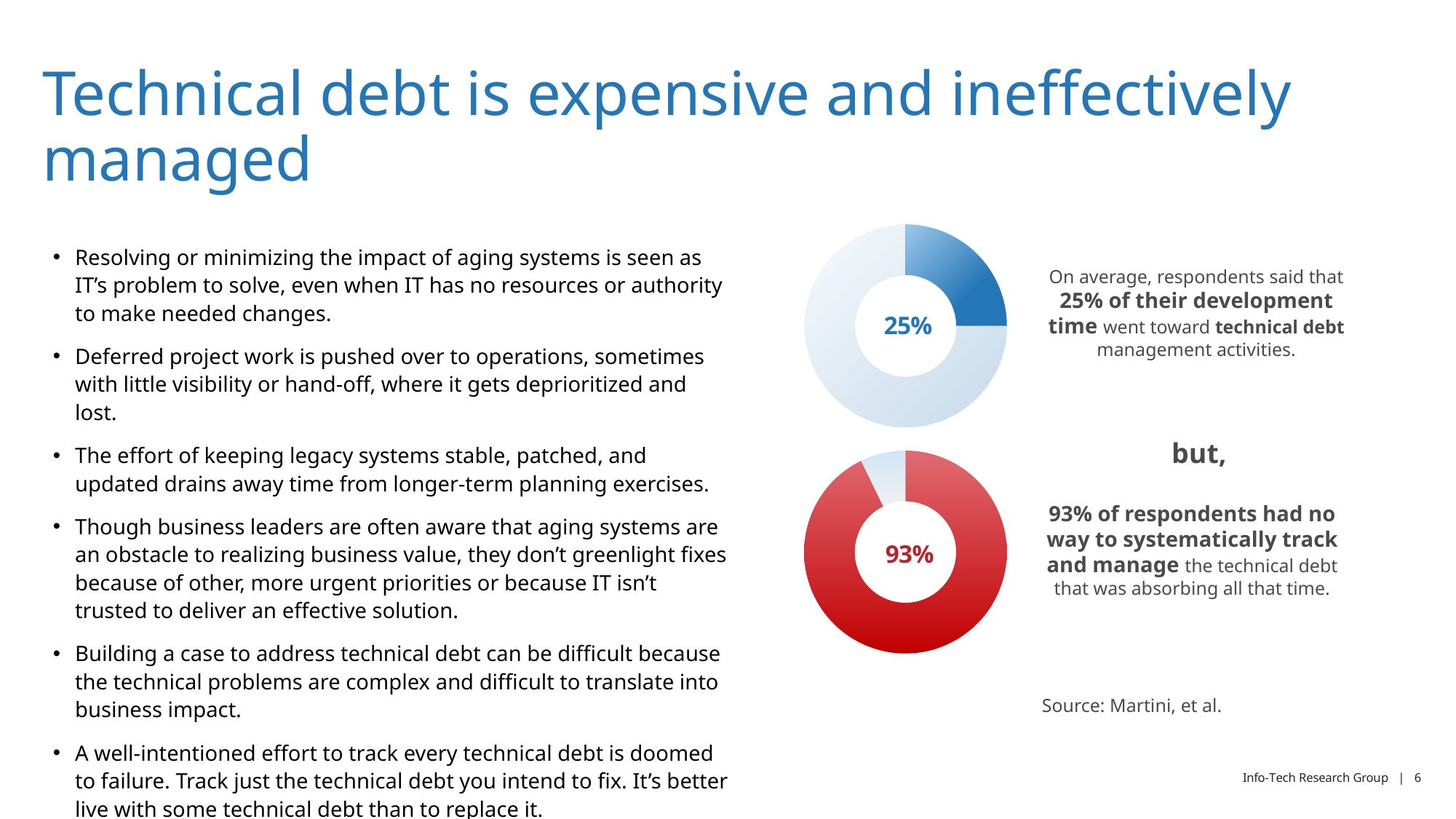
What value is printed in the centre of the bottom (red) donut chart? 93% In the top donut chart, what share of the ring is not highlighted in dark blue? 75% In the bottom donut chart, what share of the ring is not filled in red? 7% What colour is the filled portion of the bottom donut chart? Red Is the highlighted portion of the top (blue) donut chart greater or less than 50%? less Is the highlighted portion of the bottom (red) donut chart greater or less than 50%? greater What colour is the highlighted slice in the top donut chart? Blue Which donut chart shows the larger value, the top (blue) one or the bottom (red) one? The bottom (red) one What is the difference between the value in the bottom donut chart and the value in the top donut chart? 68 percentage points What value is printed in the centre of the top (blue) donut chart? 25% How many donut charts are shown on the slide? 2 What kind of chart is the top chart on the right side of the slide? Donut chart